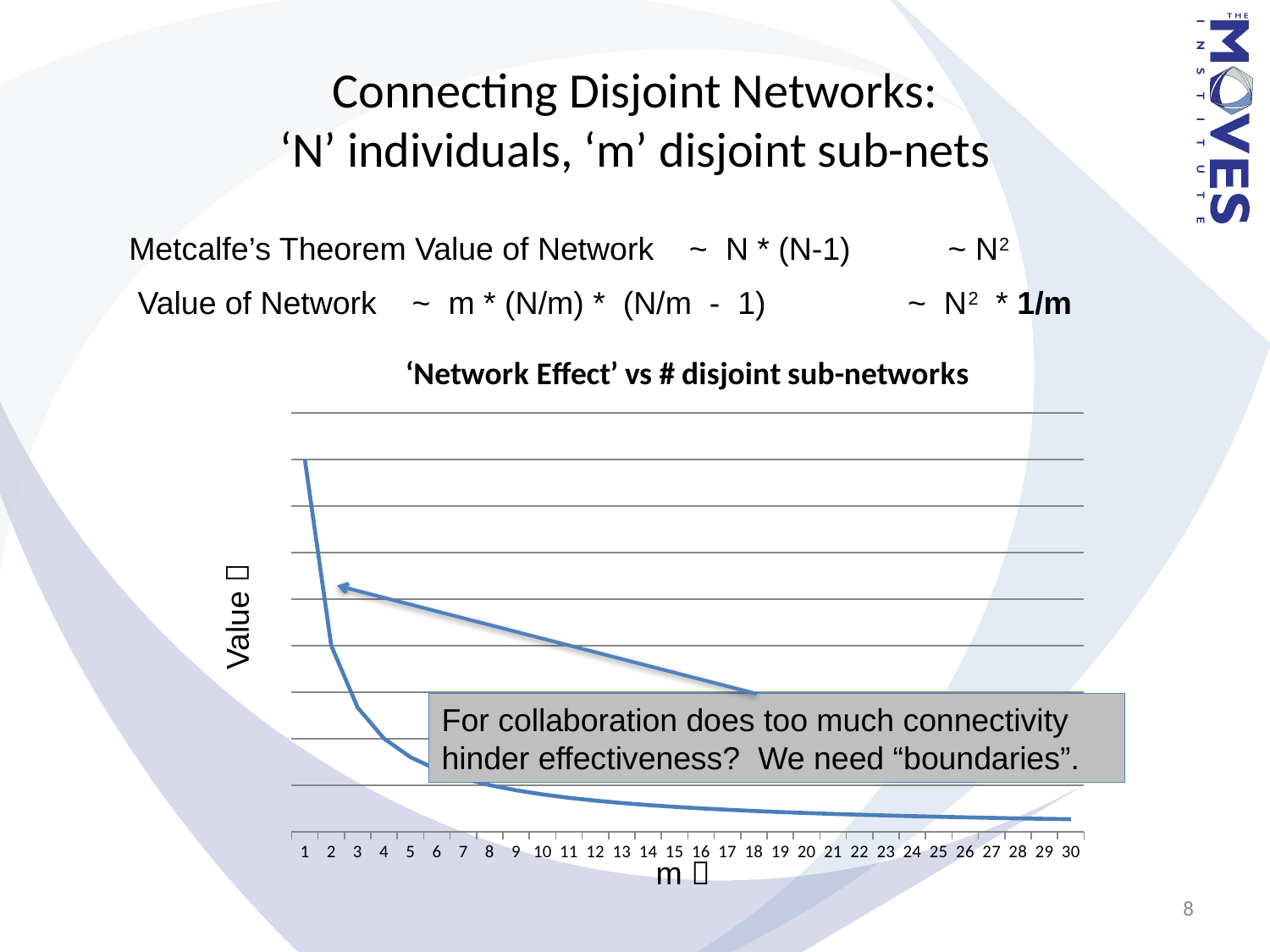
What is the label on the x axis? m What kind of chart is shown on the slide? line chart What is the title of the chart? 'Network Effect' vs # disjoint sub-networks Which has the larger value, m = 20 or m = 5? m = 5 At which value of m is the plotted value lowest? 30 Which has the larger value, m = 2 or m = 10? m = 2 How many values of m are shown on the x axis? 30 Do the values rise or fall as m increases along the x axis? fall What is the last value of m shown on the x axis? 30 What is the first value of m shown on the x axis? 1 At which value of m is the plotted value highest? 1